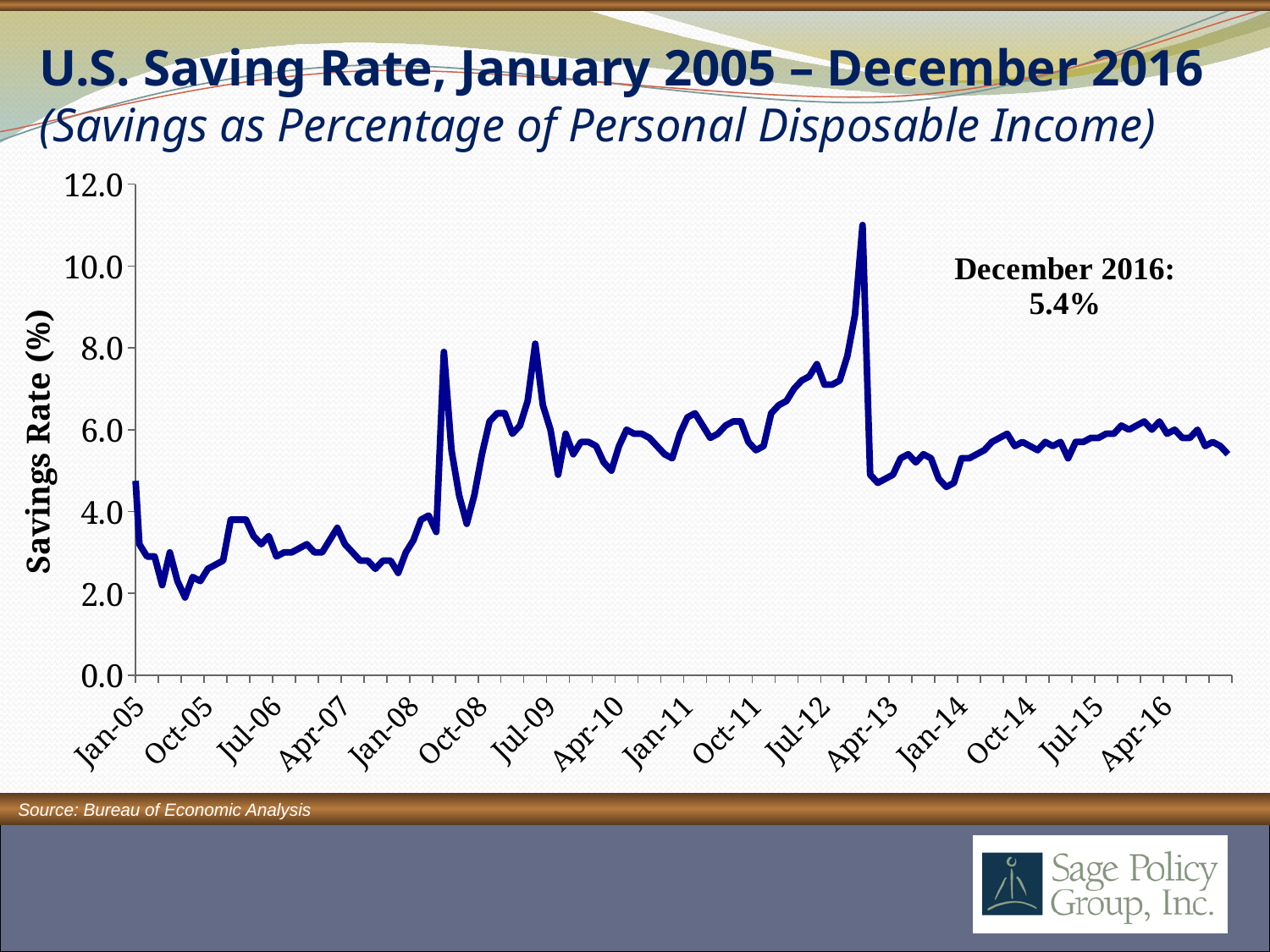
Is the value for Jan-08 greater or less than 4.0? less What source is cited for the chart data? Bureau of Economic Analysis Between which two x-axis labels does the highest peak of the line occur? Jul-12 and Apr-13 What is the saving rate for December 2016 according to the annotation on the chart? 5.4% Do the values rise or fall from Jan-05 to Oct-05? fall Which is larger, the value at Oct-05 or the value at Oct-08? Oct-08 What is the title of the y-axis? Savings Rate (%) Is the highest value on the chart greater or less than 10.0? greater Is the value for Jul-15 greater or less than 8.0? less What kind of chart is shown on the slide? line chart